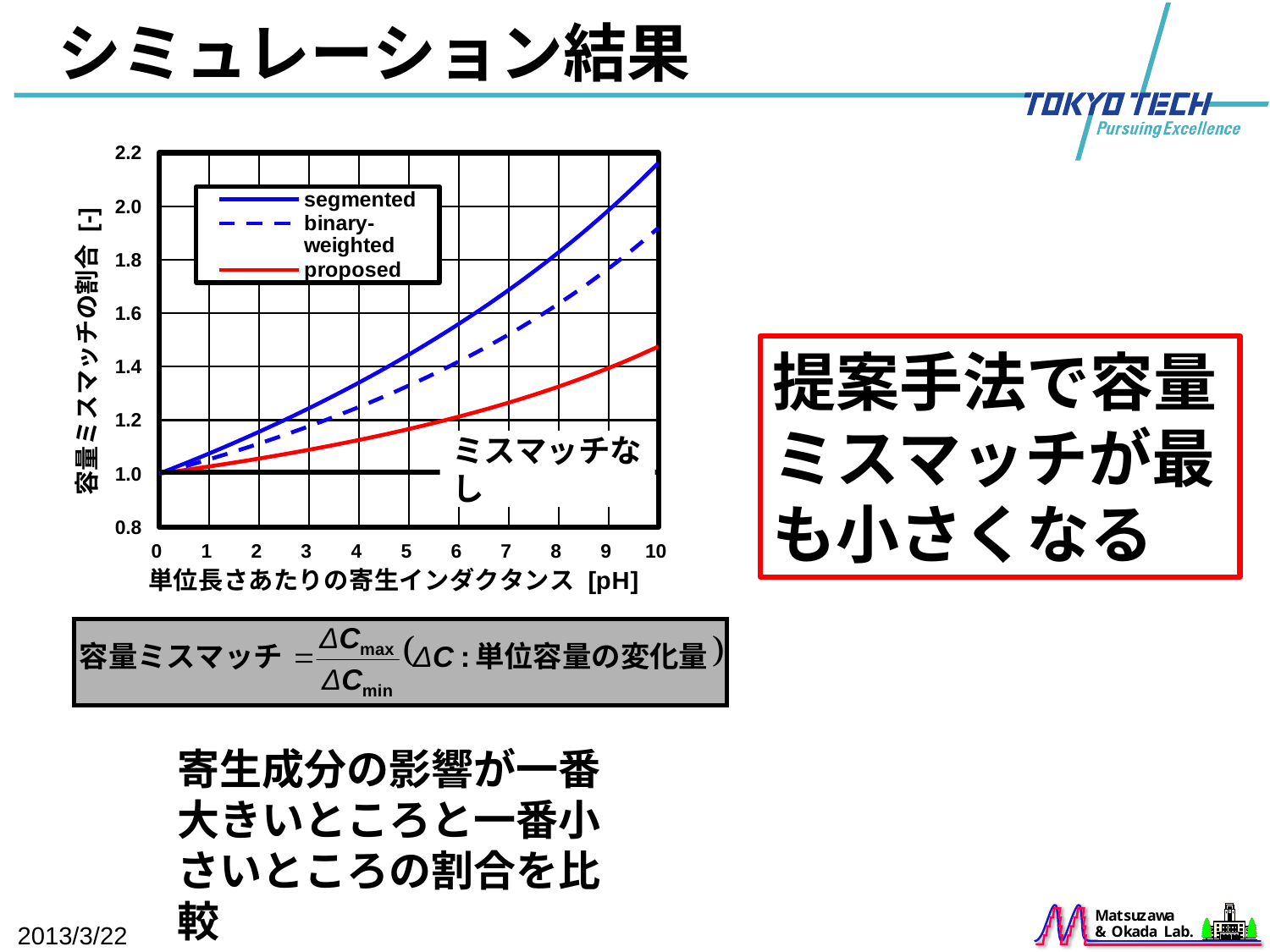
Which series has the lowest value at x = 10? proposed At x = 10, which is larger, the binary-weighted series or the proposed series? binary-weighted How many series does the legend list? 3 Is the value of the proposed series at x = 10 greater or less than 1.6? less Is the value of the binary-weighted series at x = 5 greater or less than 1.2? greater What is the label of the x axis? 単位長さあたりの寄生インダクタンス [pH] What are the three series named in the legend? segmented, binary-weighted, proposed Is the value of the segmented series at x = 10 greater or less than 2.0? greater Which series has the highest value at x = 10? segmented Do the values of the segmented series rise or fall as the x-axis value increases from 0 to 10? rise What is the value of all three series at x = 0? 1.0 What kind of chart is shown on the slide? line chart